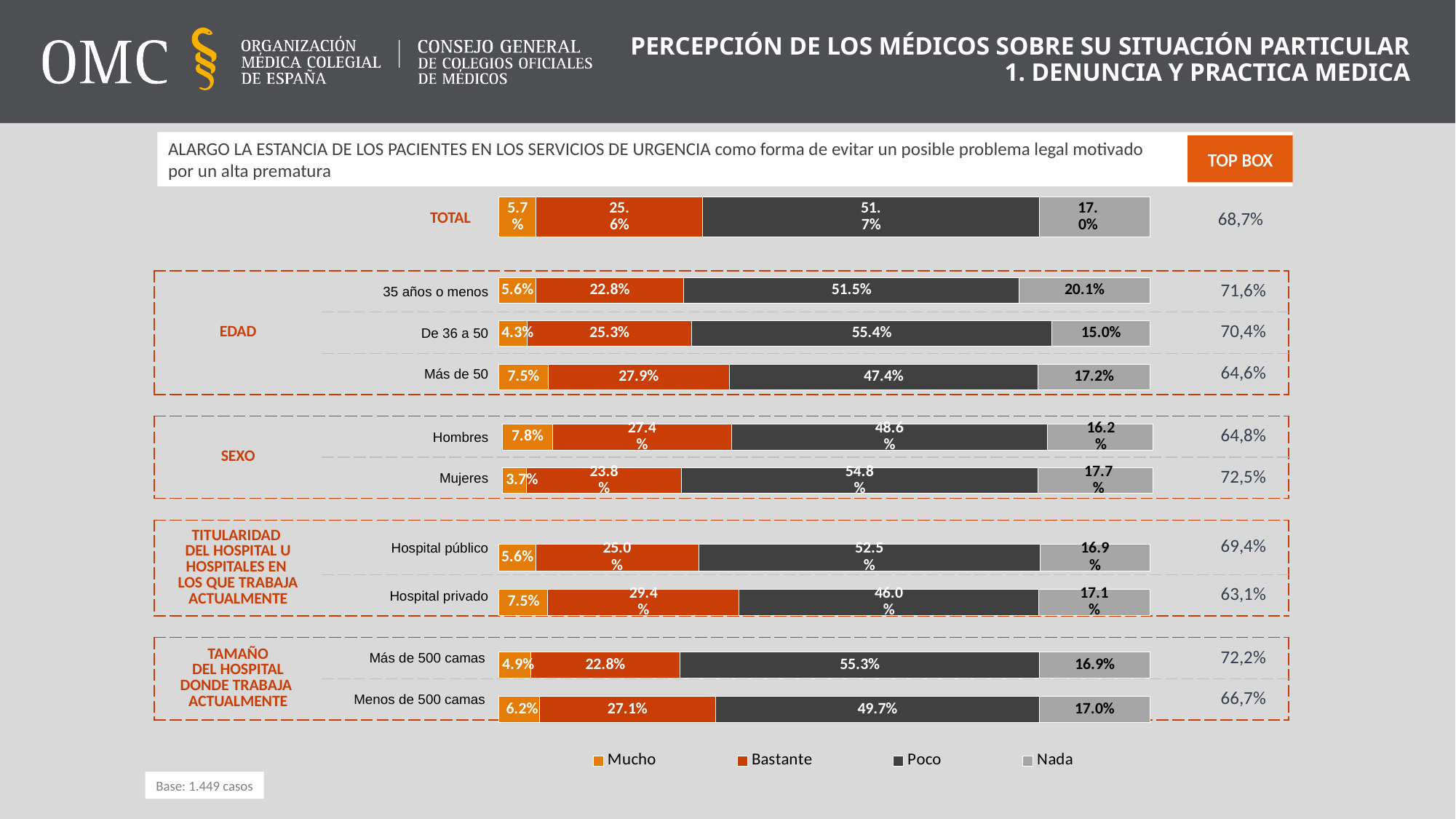
Which category has the lowest "Mucho" value? Mujeres What kind of chart is shown on the slide? Stacked bar chart Which legend entry is shown in dark grey? Poco Which has a larger "Bastante" value, Más de 50 or De 36 a 50? Más de 50 How many category bars are plotted in the chart, including TOTAL? 10 What is the "Nada" value for 35 años o menos? 20.1% How many series does the legend list? 4 What is the difference between the "Poco" values for Mujeres and Hombres? 6.2% What is the "Bastante" value for Hospital privado? 29.4% Which category has the highest "Poco" value? De 36 a 50 What is the "Mucho" value for Hombres? 7.8% What is the "Poco" value for the TOTAL bar? 51.7%